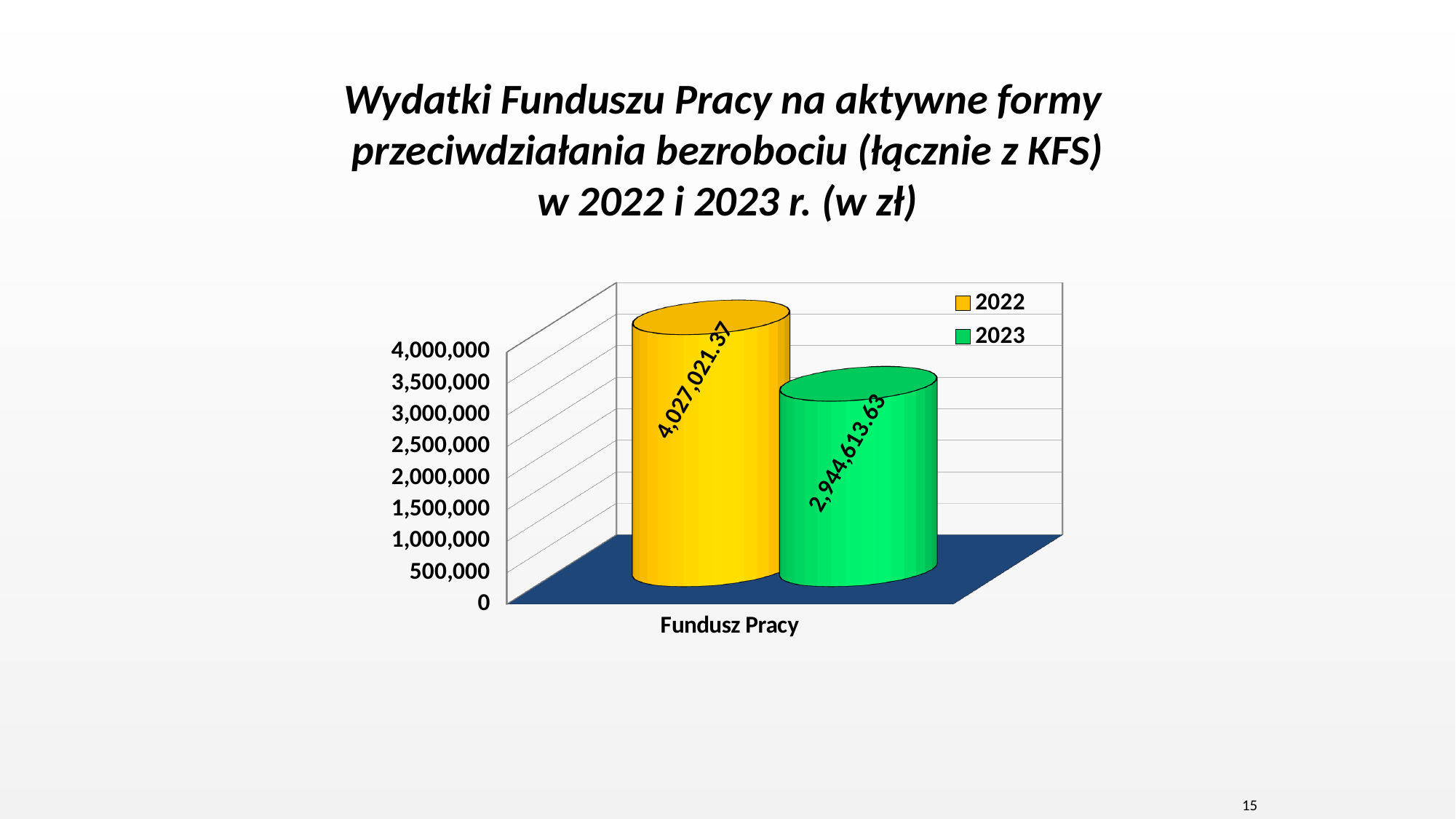
Is the value for 2023 greater or less than 3,000,000? less How many series does the legend list? 2 Which year shows the lowest value in the chart? 2023 Is the value for 2022 greater or less than 4,000,000? greater What is the value for 2022 in the chart? 4,027,021.37 What kind of chart is shown on the slide? bar chart Which year shows the highest value in the chart? 2022 What is the difference between the 2022 value and the 2023 value? 1,082,407.74 What is the value for 2023 in the chart? 2,944,613.63 How many categories are shown on the x axis? 1 Which series has the higher value, 2022 or 2023? 2022 What is the category label shown on the x axis? Fundusz Pracy